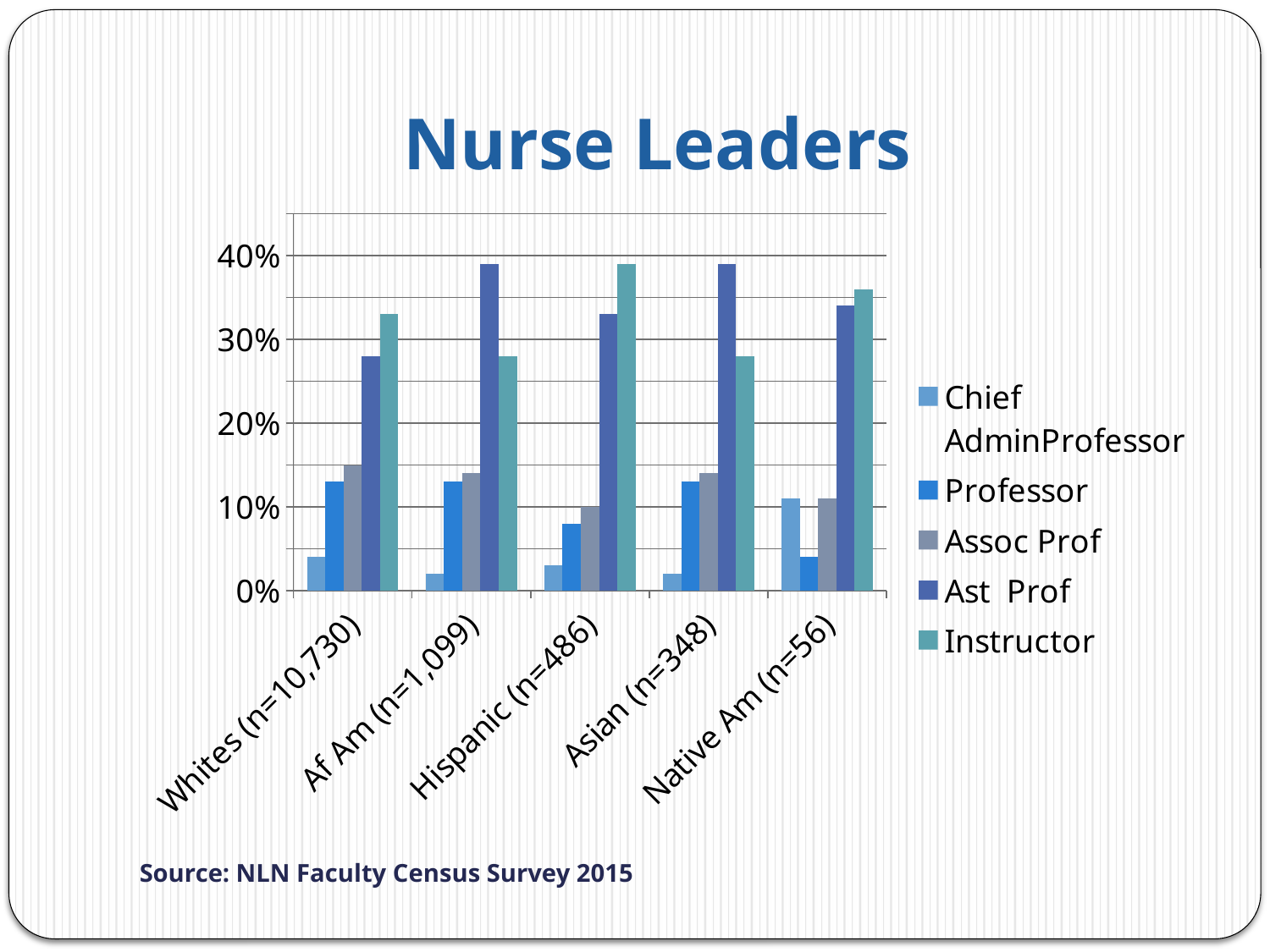
Is the Instructor value for Whites (n=10,730) greater or less than 30%? greater What is the title of the chart? Nurse Leaders Which series has the lowest value for Asian (n=348)? Chief Admin Is the Ast Prof value for Af Am (n=1,099) greater or less than 30%? greater Is the Professor value for Native Am (n=56) greater or less than 10%? less For Whites (n=10,730), which is larger: the Instructor value or the Ast Prof value? Instructor For Af Am (n=1,099), which is larger: the Ast Prof value or the Instructor value? Ast Prof Which category has the highest Chief Admin value? Native Am (n=56) What kind of chart is shown on the slide? bar chart How many series does the legend list? 5 How many racial/ethnic categories are shown on the x axis? 5